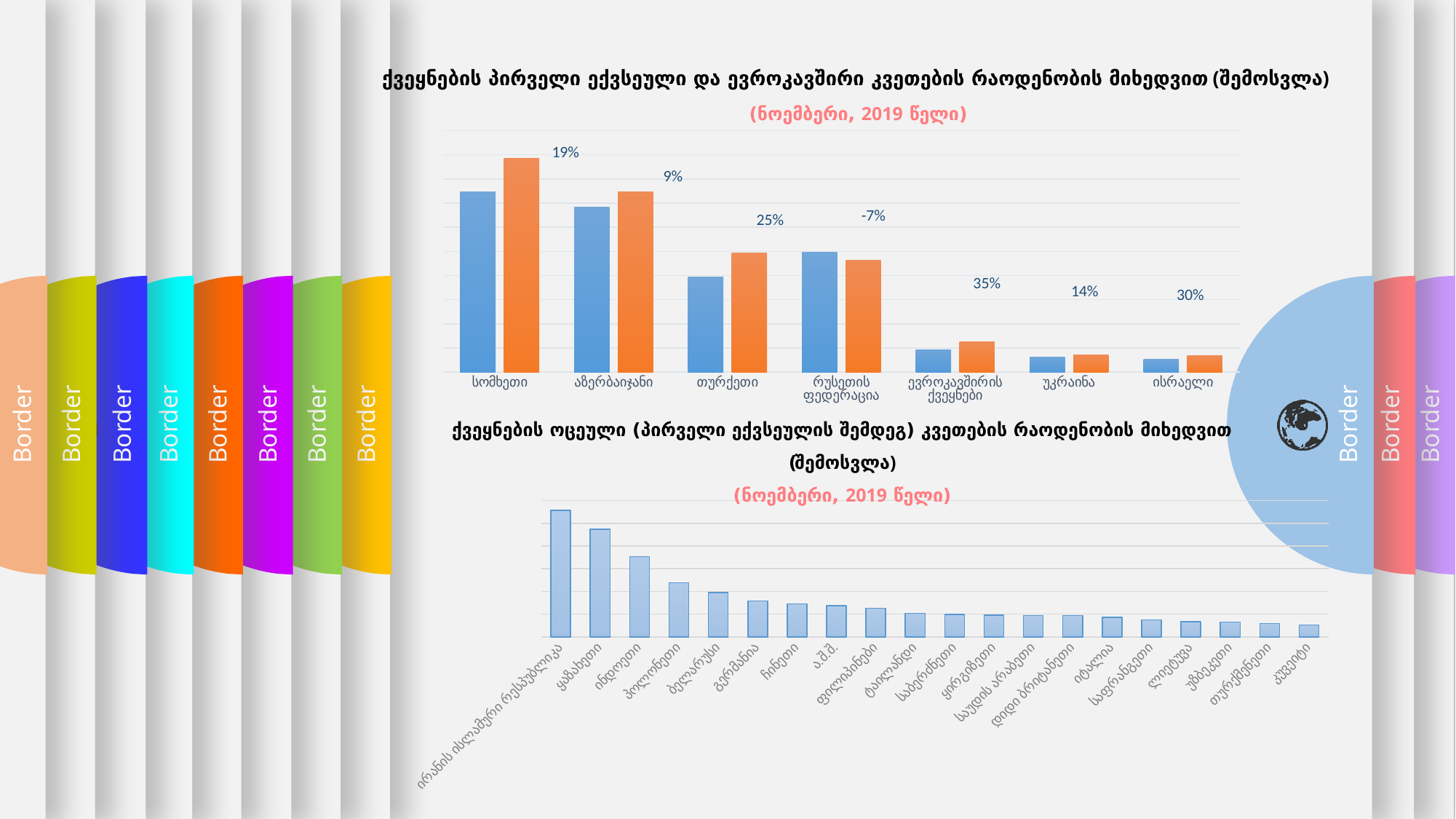
In the top chart, which category has the highest percentage label? ევროკავშირის ქვეყნები In the bottom chart, which category has the tallest bar? ირანის ისლამური რესპუბლიკა How many categories are shown on the x axis of the bottom chart? 20 In the top chart, what is the difference between the percentage labels for ევროკავშირის ქვეყნები and ისრაელი? 5% In the top chart, which category has the lowest percentage label? რუსეთის ფედერაცია In the top chart, what percentage label is shown above the bars for ისრაელი? 30% In the top chart, is the blue bar for რუსეთის ფედერაცია taller or shorter than the blue bar for თურქეთი? taller How many categories are shown on the x axis of the top chart? 7 In the top chart, which category has the tallest orange bar? სომხეთი In the top chart, what percentage label is shown above the bars for სომხეთი? 19% In the top chart, what percentage label is shown above the bars for რუსეთის ფედერაცია? -7% In the top chart, what percentage label is shown above the bars for ევროკავშირის ქვეყნები? 35%